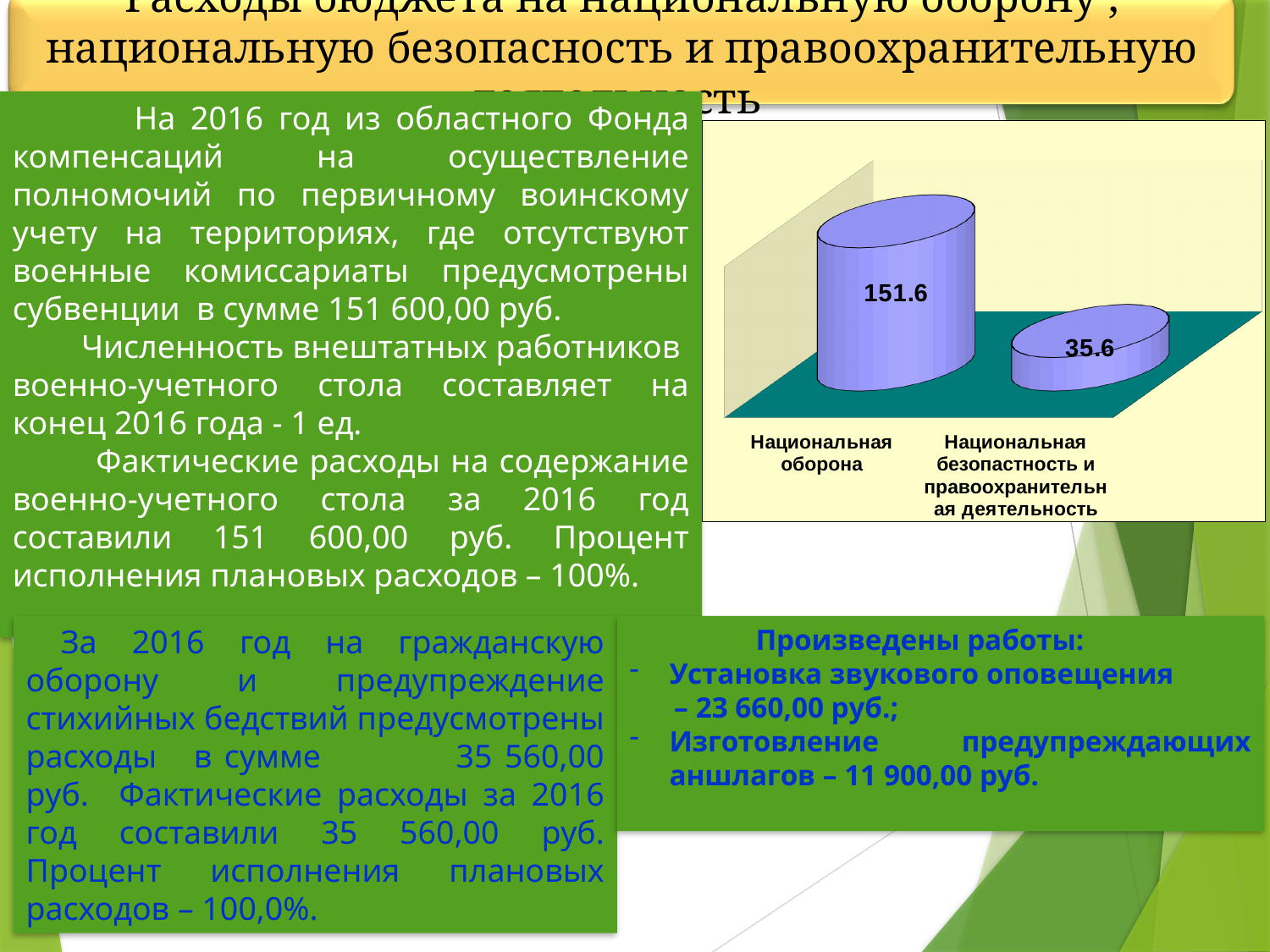
What is the value shown for Национальная оборона? 151.6 Do the values rise or fall from left to right across the categories? Fall What kind of chart is shown on the slide? Bar chart What is the difference between the values for Национальная оборона and Национальная безопастность и правоохранительная деятельность? 116 Which category has the highest value in the chart? Национальная оборона What is the value shown for Национальная безопастность и правоохранительная деятельность? 35.6 What colour are the bars in the chart? Blue (light purple-blue) Which is larger: the value for Национальная оборона or the value for Национальная безопастность и правоохранительная деятельность? Национальная оборона How many categories are plotted in the chart? 2 What is the total of the two values plotted in the chart? 187.2 Which category has the lowest value in the chart? Национальная безопастность и правоохранительная деятельность